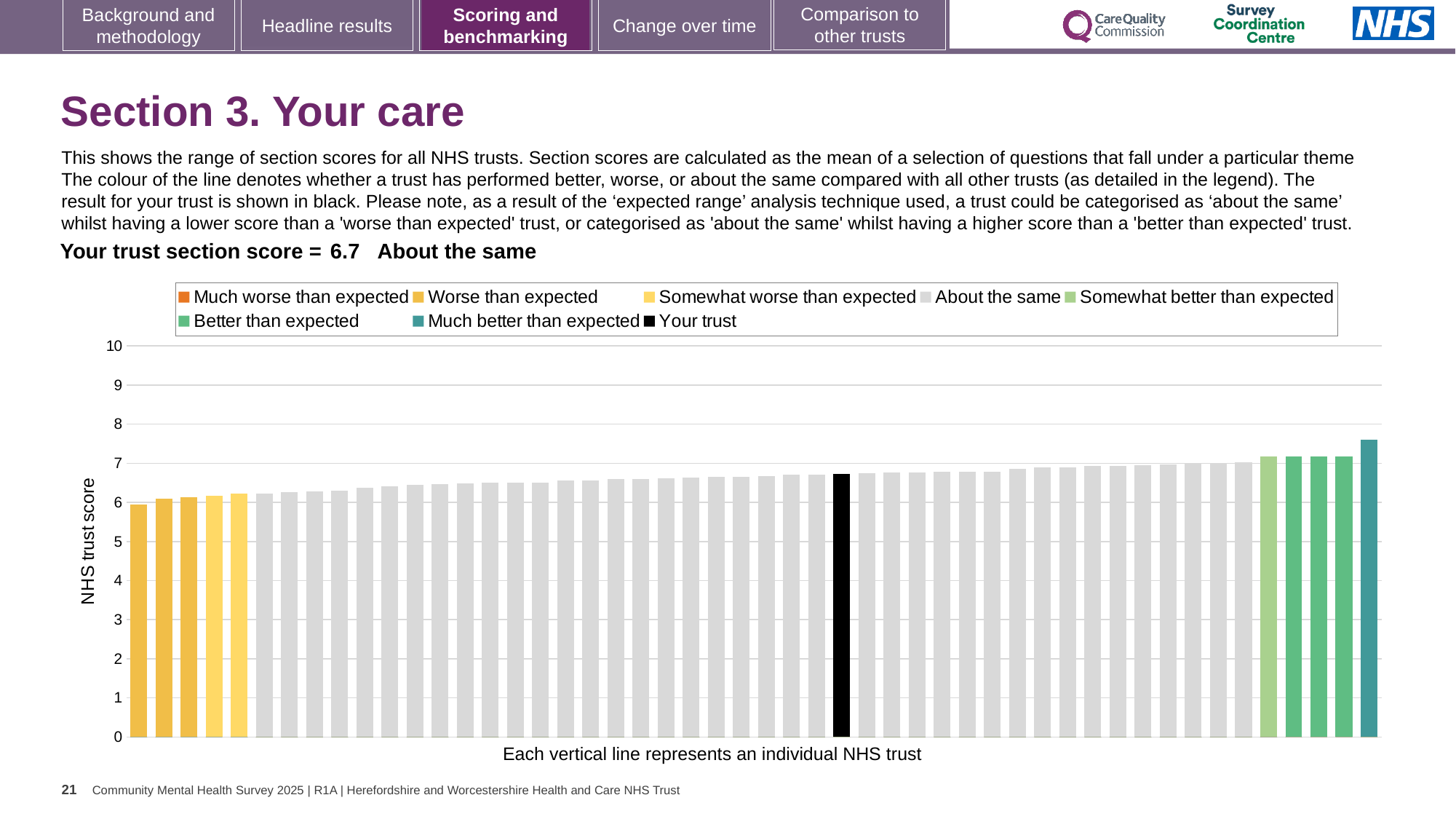
What is the label on the vertical axis of the chart? NHS trust score How many bars are coloured as 'Much worse than expected' on the chart? 0 Which is larger: the value for your trust (black bar) or the value of the leftmost bar? Your trust Which performance category is your trust placed in for Section 3? About the same Is the value for your trust (the black bar) greater or less than 6? greater How many entries does the chart legend list? 8 Is the value of the tallest bar greater or less than 8? less Which legend category does the tallest bar on the chart belong to? Much better than expected What is the section score for your trust shown on the slide? 6.7 Do the bar values rise or fall from left to right along the x axis? rise What kind of chart is shown on the slide? bar chart Is the value of the tallest bar greater or less than 7? greater